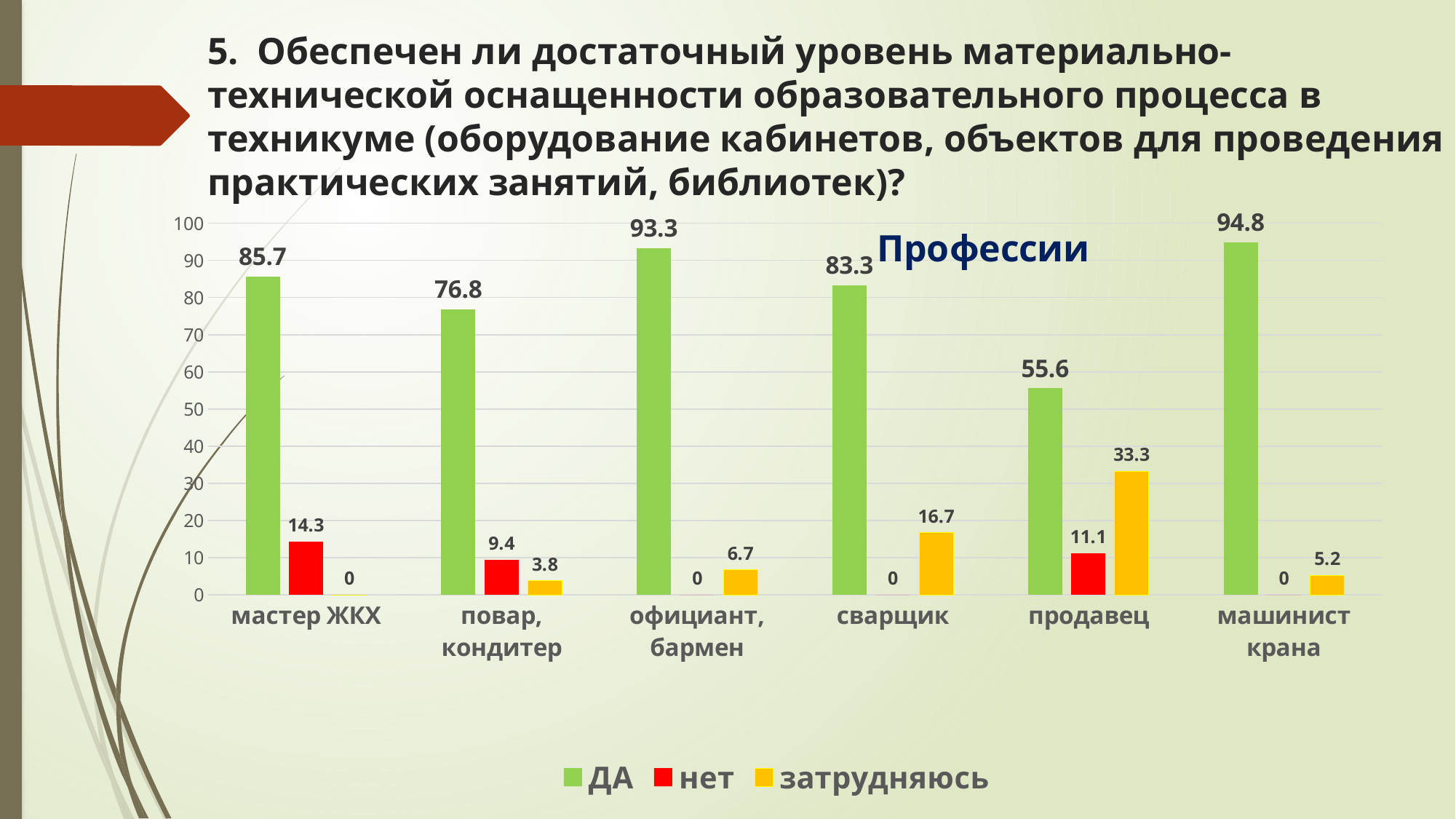
Which category has the highest value in the ДА series? машинист крана Which is larger: the нет value for мастер ЖКХ or the нет value for продавец? мастер ЖКХ Is the ДА value for продавец greater or less than 60? less What kind of chart is shown on the slide? bar chart How many series does the legend list? 3 What is the value of the нет series for повар, кондитер? 9.4 What is the difference between the ДА values for официант, бармен and сварщик? 10 Which colour represents the нет series in the chart? red What is the value of the ДА series for мастер ЖКХ? 85.7 How many categories (professions) are shown on the x axis? 6 What is the value of the затрудняюсь series for продавец? 33.3 Which category has the lowest value in the ДА series? продавец